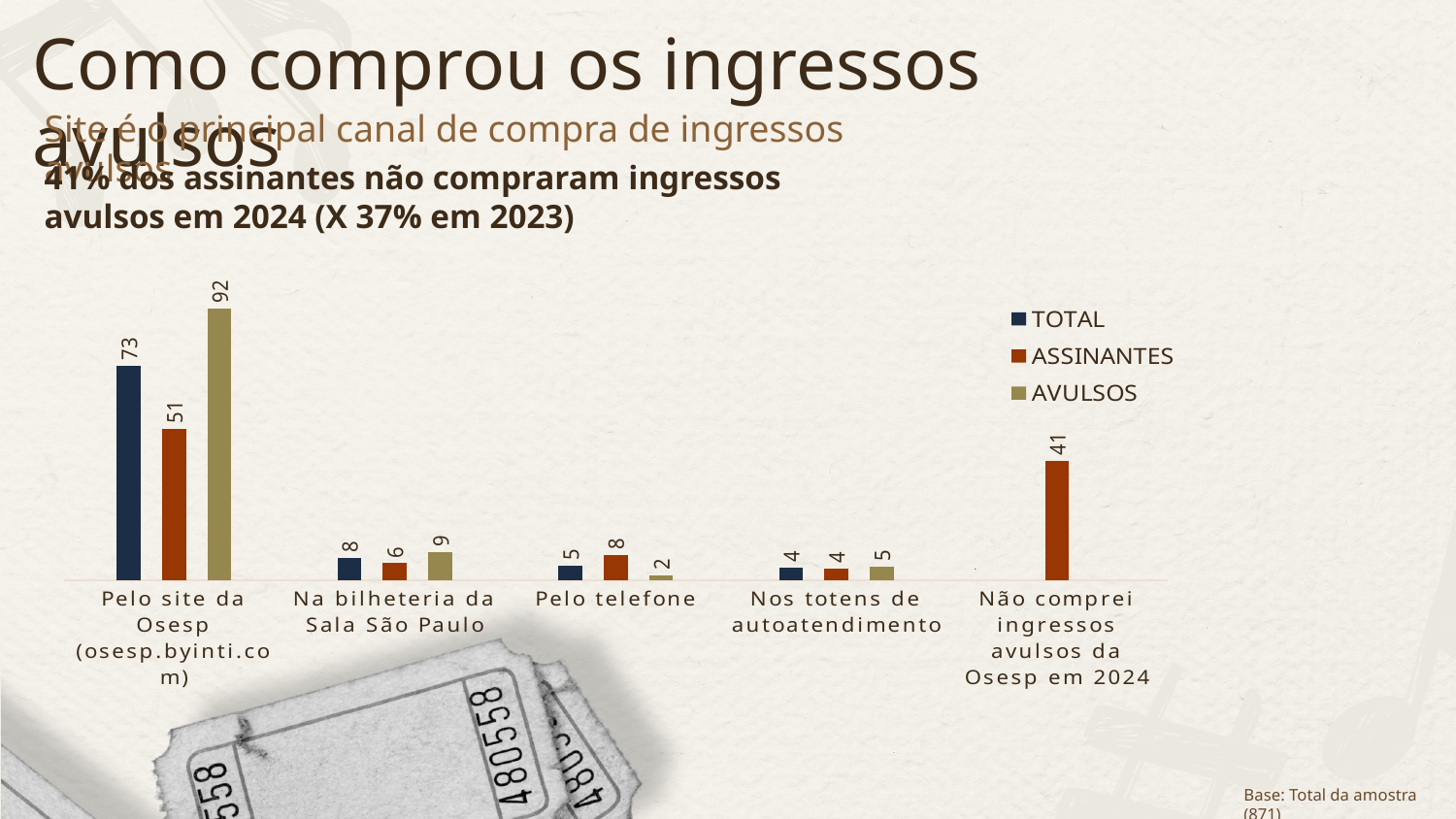
What is the TOTAL value for "Pelo site da Osesp (osesp.byinti.com)"? 73 Which category has the highest TOTAL value? Pelo site da Osesp (osesp.byinti.com) What is the AVULSOS value for "Pelo site da Osesp (osesp.byinti.com)"? 92 What is the ASSINANTES value for "Não comprei ingressos avulsos da Osesp em 2024"? 41 How many series does the legend list? 3 For "Na bilheteria da Sala São Paulo", which is larger: the TOTAL value or the ASSINANTES value? TOTAL What kind of chart is shown on the slide? bar chart Which series is shown in the dark blue colour in the legend? TOTAL What is the difference between the AVULSOS and ASSINANTES values for "Pelo site da Osesp (osesp.byinti.com)"? 41 What is the ASSINANTES value for "Pelo telefone"? 8 How many categories are shown on the x axis? 5 Which category has the lowest AVULSOS value? Pelo telefone